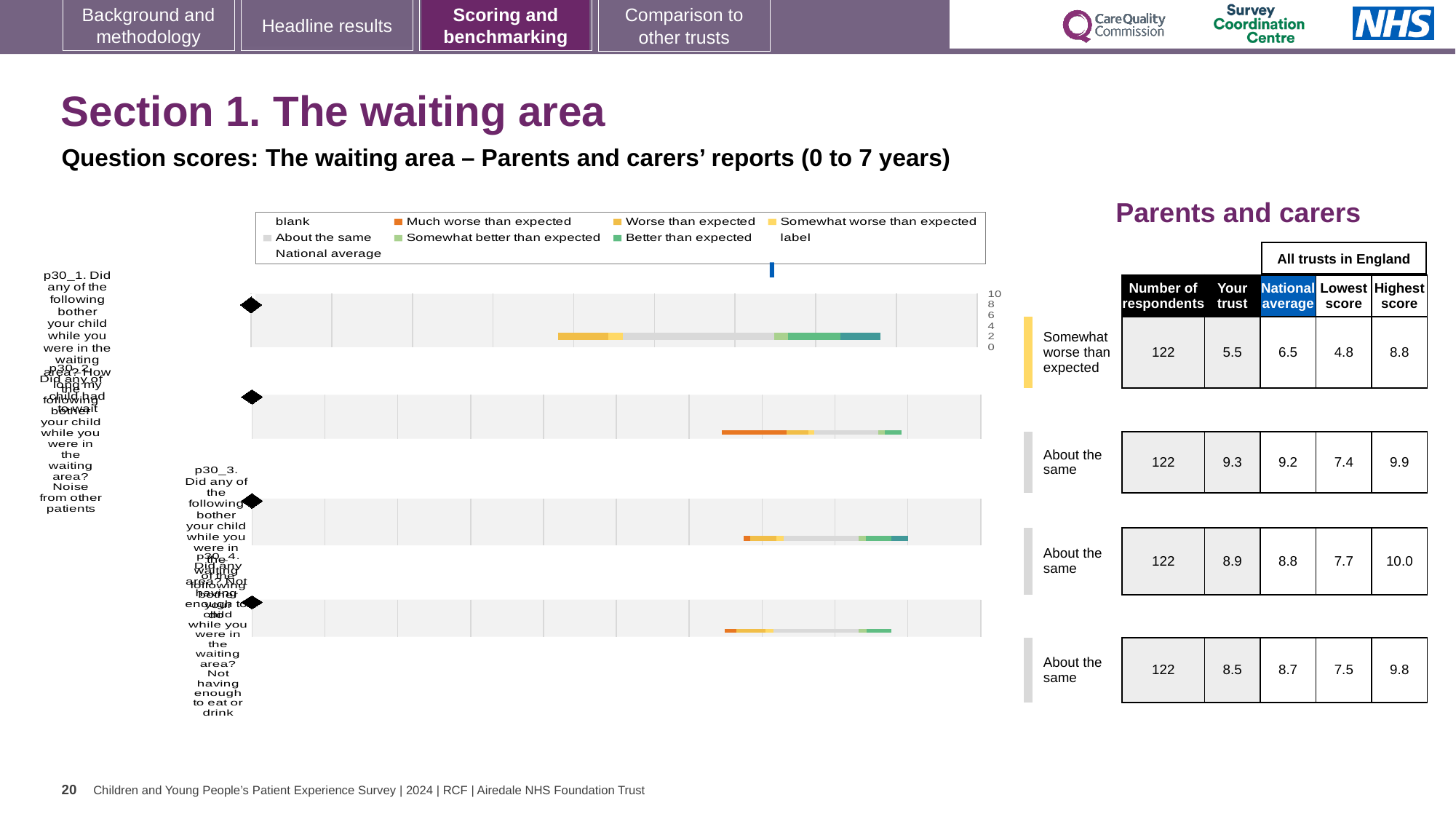
In the table beside the chart, which question has the highest 'Your trust' score? p30_2 (9.3) In the table beside the chart, what is the number of respondents for the first question (p30_1)? 122 What colour represents 'Much worse than expected' in the chart legend? orange In the table beside the chart, is the 'Your trust' score for the fourth question (p30_4) higher or lower than the national average? lower How many question bars are plotted in the chart? 4 In the table beside the chart, what is the 'Your trust' score for the first question (p30_1)? 5.5 What is the maximum value shown on the chart's x axis? 10 In the table beside the chart, what is the difference between the national average and the 'Your trust' score for the first question (p30_1)? 1.0 What kind of chart is shown on the slide? bar chart How many entries does the chart legend list? 9 In the table beside the chart, what is the highest score across all trusts for the third question (p30_3)? 10.0 In the table beside the chart, what is the national average for the first question (p30_1)? 6.5